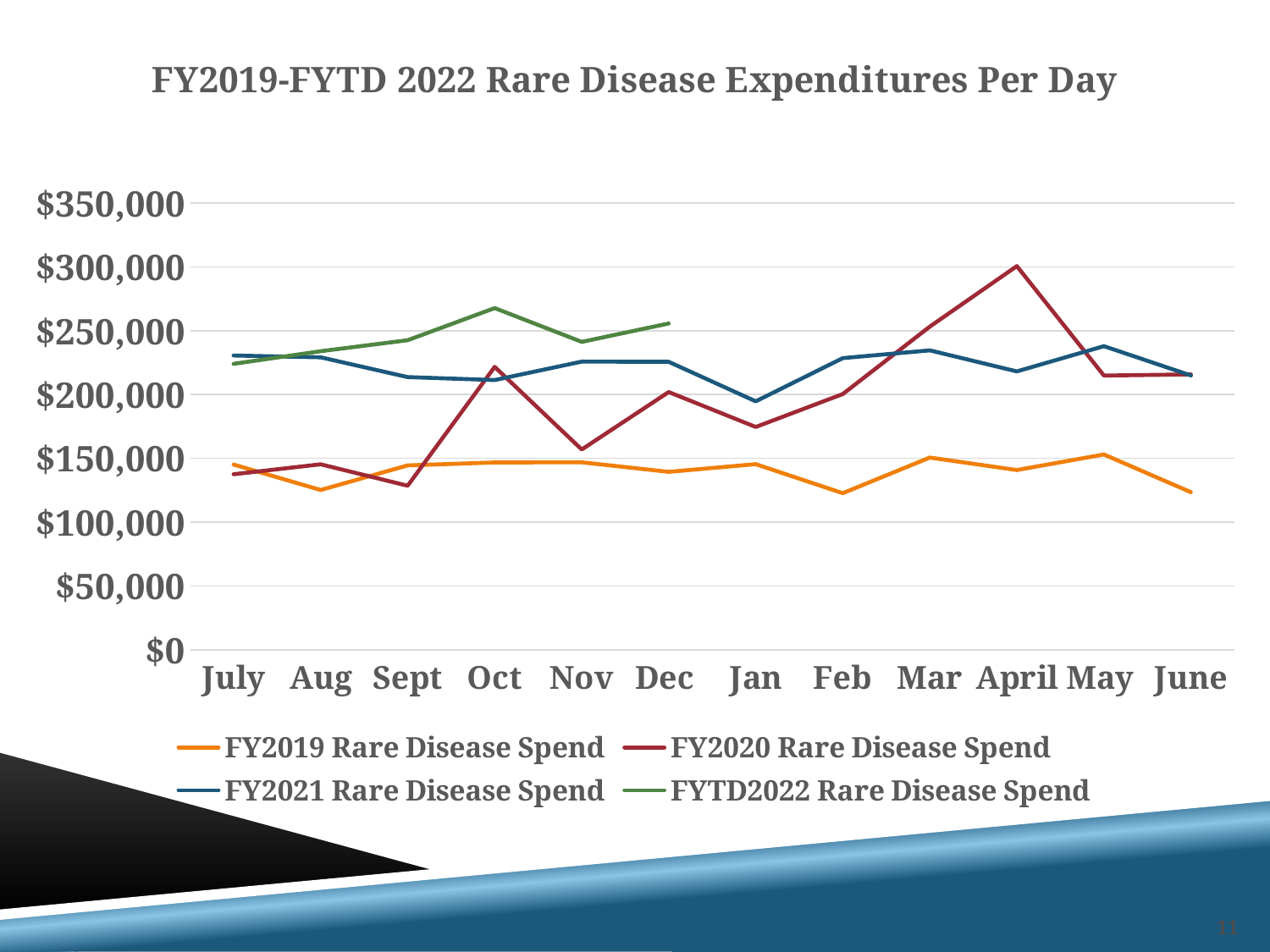
Is the FY2019 Rare Disease Spend value for Aug greater or less than $150,000? less In which month does the FY2021 Rare Disease Spend series reach its lowest value? Jan In which month does the FY2020 Rare Disease Spend series reach its highest value? April How many months have a plotted value for the FYTD2022 Rare Disease Spend series? 6 How many series does the legend list? 4 How many months are shown along the x axis? 12 Is the FY2020 Rare Disease Spend value for Nov greater or less than $200,000? less In which month does the FYTD2022 Rare Disease Spend series reach its highest value? Oct Is the FY2020 Rare Disease Spend value for April greater or less than $250,000? greater Does the FY2020 Rare Disease Spend series rise or fall from Jan to April? Rise What type of chart is shown on the slide? Line chart In Oct, which series has the higher value: FY2020 Rare Disease Spend or FY2019 Rare Disease Spend? FY2020 Rare Disease Spend